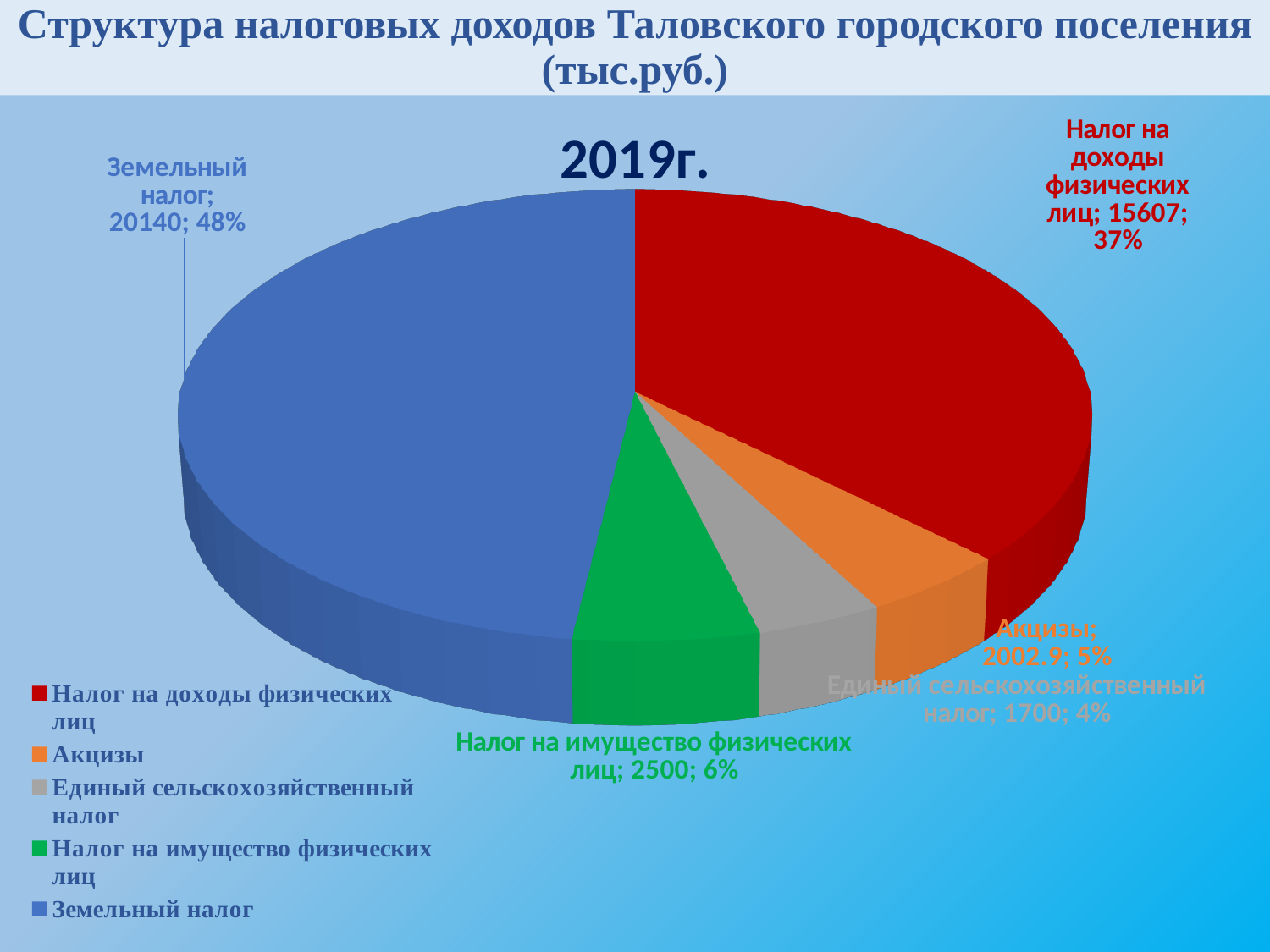
What kind of chart is shown on the slide? Pie chart How many categories does the legend list? 5 What is the value for Налог на доходы физических лиц? 15607 What is the value for Акцизы? 2002.9 What is the difference between the values for Земельный налог and Налог на доходы физических лиц? 4533 What is the value for Единый сельскохозяйственный налог? 1700 What is the value for Земельный налог in the 2019г. pie chart? 20140 What share of the pie does Земельный налог represent? 48% What share of the pie does Налог на имущество физических лиц represent? 6% Which category has the largest slice of the pie? Земельный налог Which category has the smallest slice of the pie? Единый сельскохозяйственный налог Which is larger, the value for Налог на имущество физических лиц or the value for Акцизы? Налог на имущество физических лиц